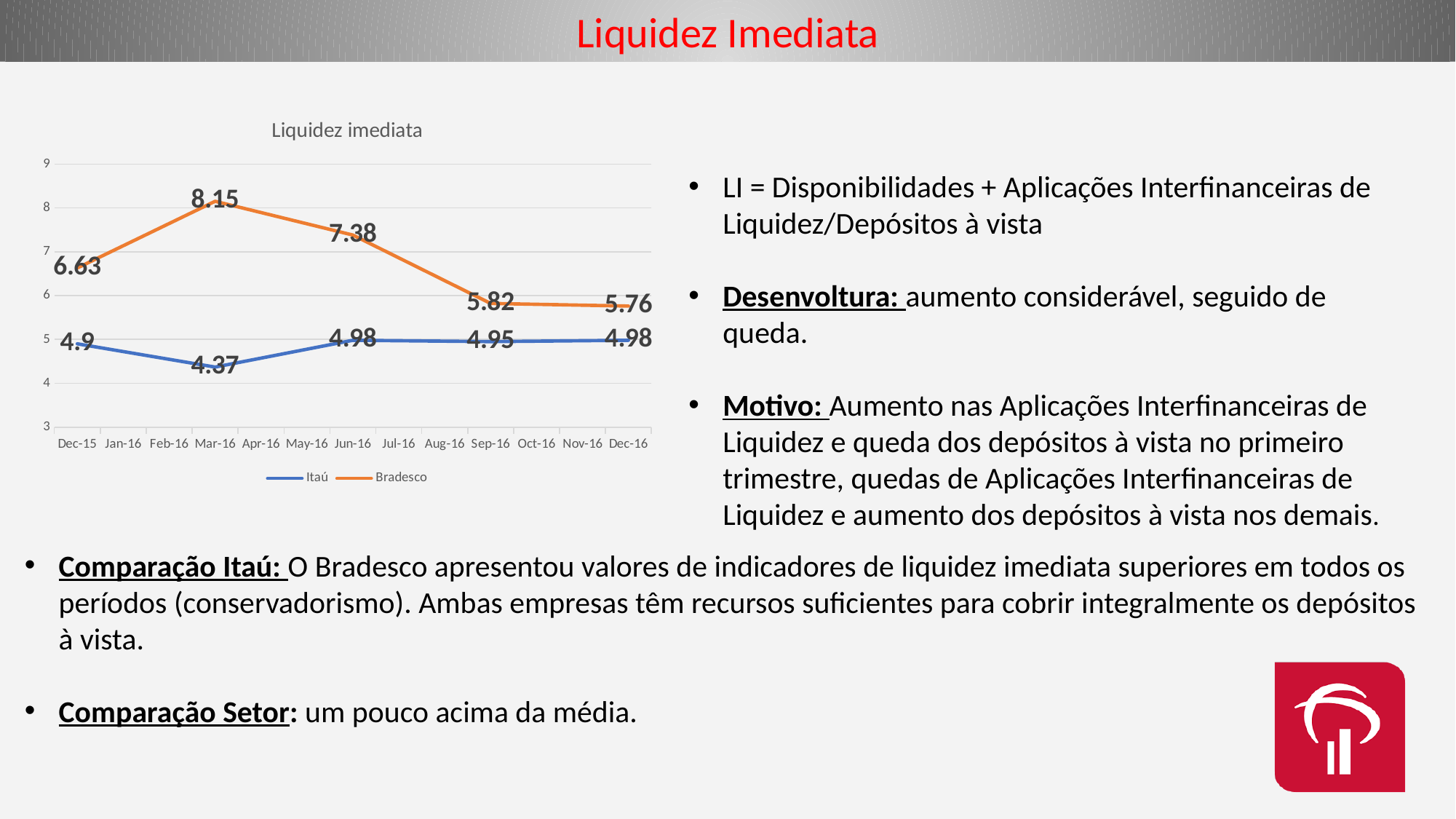
What is the Itaú value in Mar-16? 4.37 Which series has the higher value in Sep-16, Itaú or Bradesco? Bradesco In which month does Bradesco reach its highest value? Mar-16 In which month does Itaú reach its lowest value? Mar-16 How many series does the legend list? 2 What is the difference between the Bradesco and Itaú values in Mar-16? 3.78 What kind of chart is shown? Line chart Does the Bradesco series rise or fall from Mar-16 to Dec-16? Fall What colour is the Bradesco line? Orange What is the Itaú value in Dec-15? 4.9 What is the Bradesco value in Mar-16? 8.15 What is the Bradesco value in Dec-16? 5.76